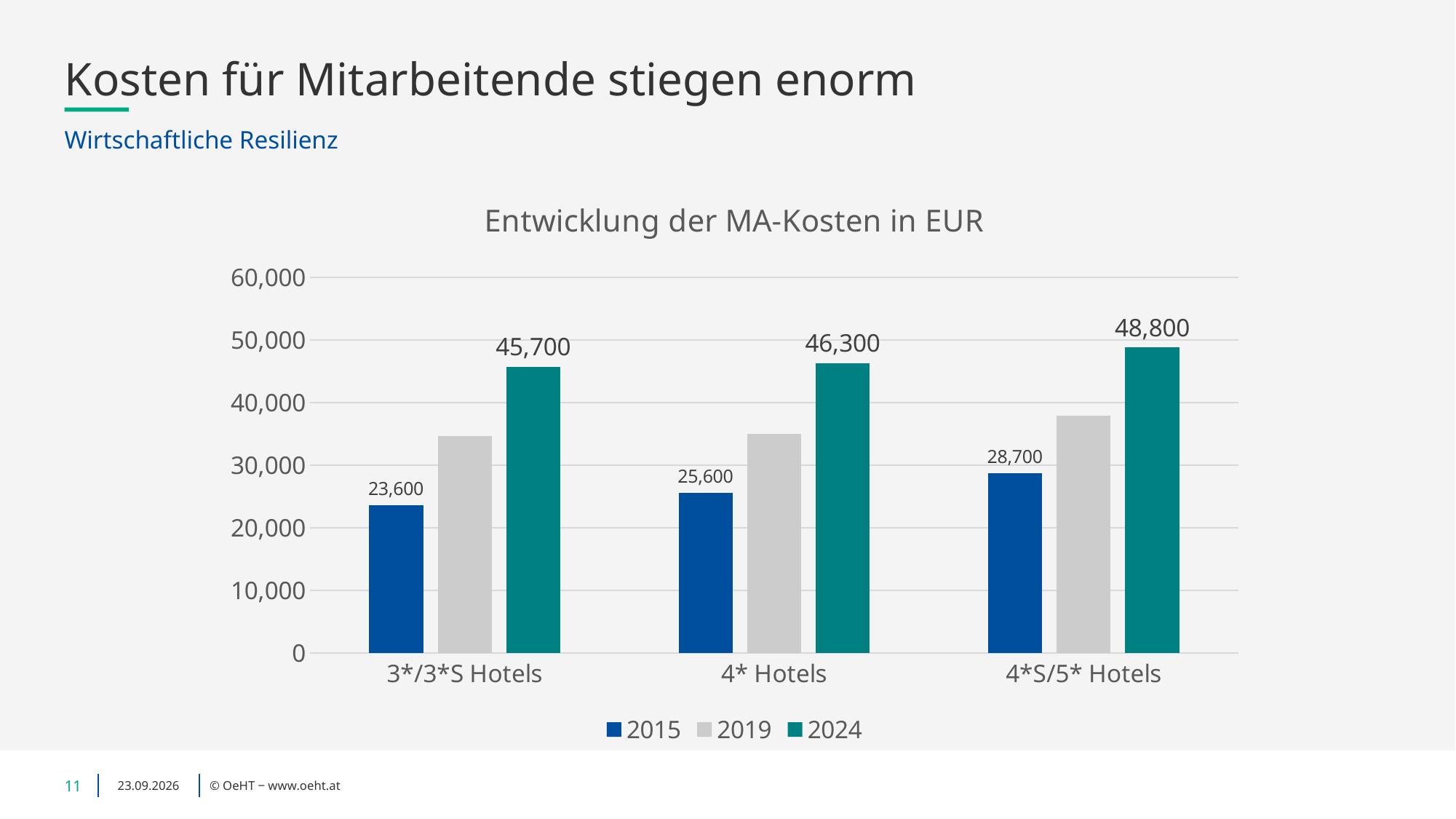
What is the 2015 value for 3*/3*S Hotels? 23,600 How many series does the legend list? 3 What is the difference between the 2024 values for 4*S/5* Hotels and 4* Hotels? 2,500 What is the 2024 value for 4*S/5* Hotels? 48,800 Is the 2019 value for 4*S/5* Hotels greater or less than 40,000? less What type of chart is shown on the slide? Bar chart Is the 2019 value for 3*/3*S Hotels greater or less than 30,000? greater What is the 2024 value for 4* Hotels? 46,300 What is the difference between the 2024 and 2015 values for 3*/3*S Hotels? 22,100 What is the 2015 value for 4*S/5* Hotels? 28,700 Which hotel category has the highest 2024 value? 4*S/5* Hotels Which hotel category has the lowest 2015 value? 3*/3*S Hotels